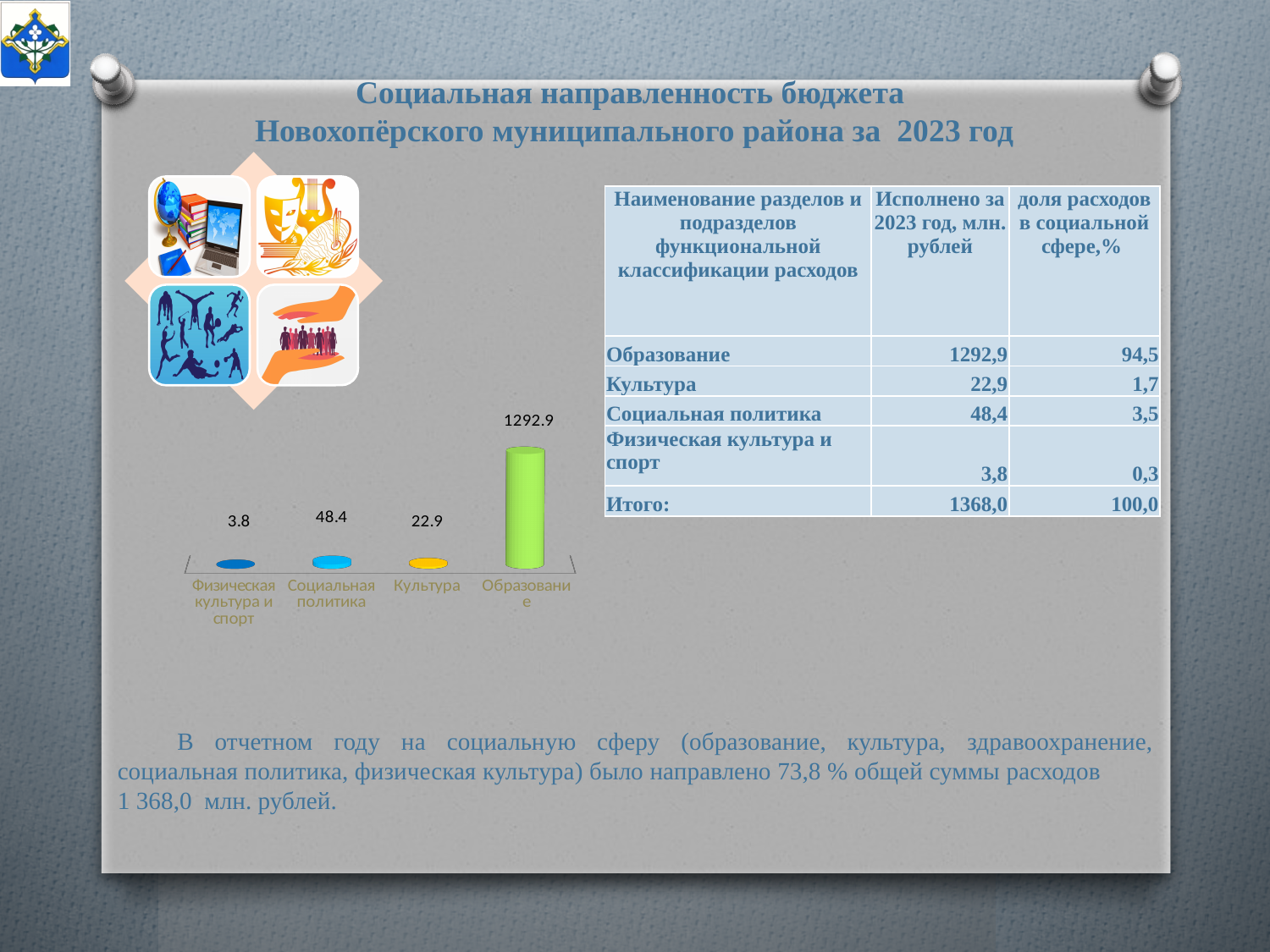
Which category has the highest value in the chart? Образование Which is larger in the chart, the value for Культура or the value for Социальная политика? Социальная политика What kind of chart is shown on the slide? Bar chart Which category has the lowest value in the chart? Физическая культура и спорт What value is shown for Образование in the chart? 1292.9 What value is shown for Культура in the chart? 22.9 How many categories are shown in the chart? 4 What colour is the bar for Образование in the chart? Green What is the difference between the values for Образование and Социальная политика in the chart? 1244.5 What value is shown for Социальная политика in the chart? 48.4 What value is shown for Физическая культура и спорт in the chart? 3.8 What is the difference between the values for Социальная политика and Культура in the chart? 25.5